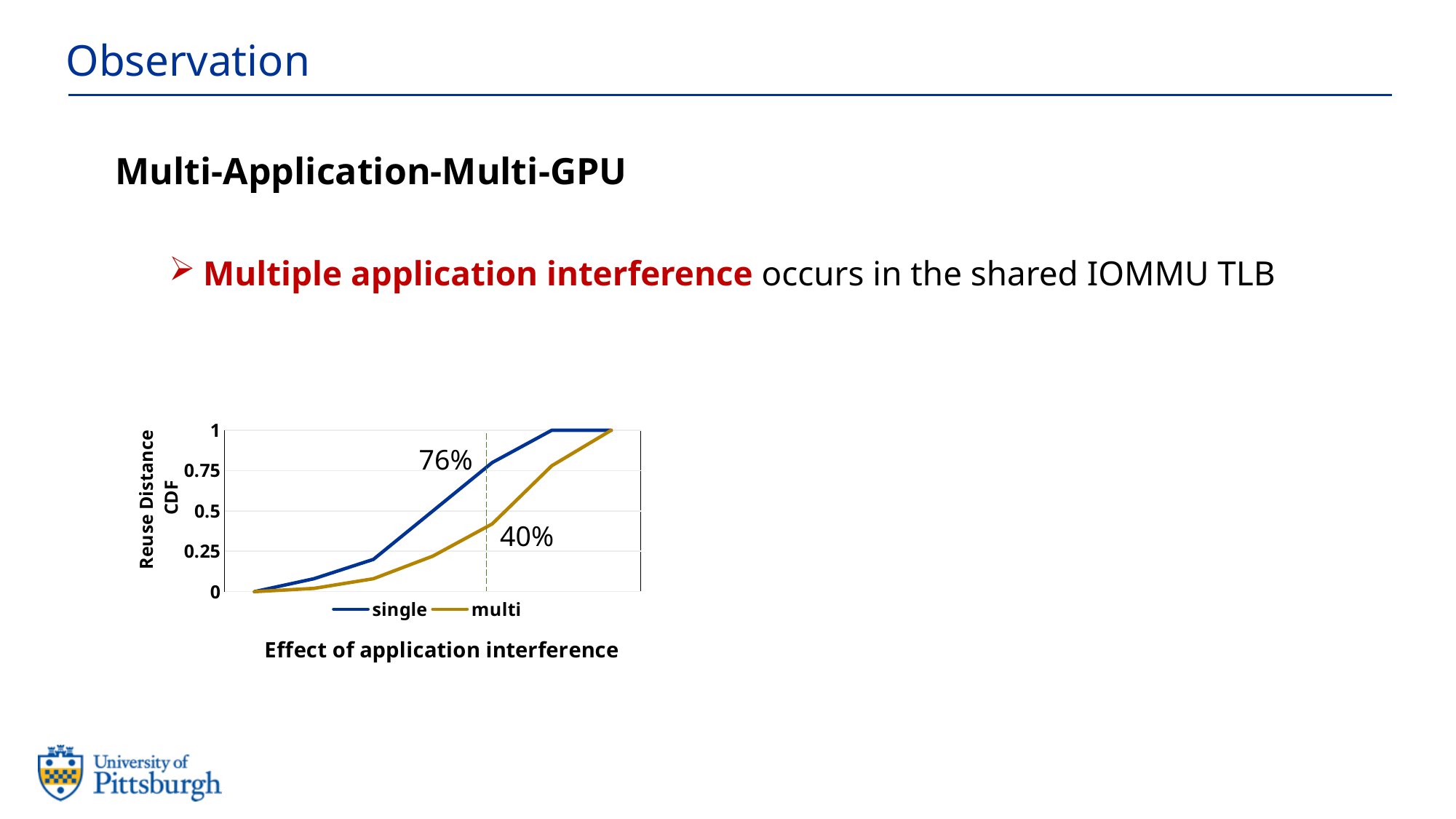
At the dashed vertical line, is the CDF value for the single series greater or less than 0.5? greater Do the CDF curves rise or fall as you move along the x axis? rise What CDF value is annotated for the multi series at the dashed vertical line? 40% At the dashed vertical line, which series has the higher CDF value, single or multi? single What is the label of the y axis of the chart? Reuse Distance CDF What CDF value is annotated for the single series at the dashed vertical line? 76% How many series does the legend of the chart list? 2 At the dashed vertical line, is the CDF value for the multi series greater or less than 0.5? less What is the title printed below the chart? Effect of application interference What is the difference between the annotated CDF values of the single and multi series at the dashed line? 36% What kind of chart is shown on the slide? line chart What are the two series named in the chart legend? single and multi